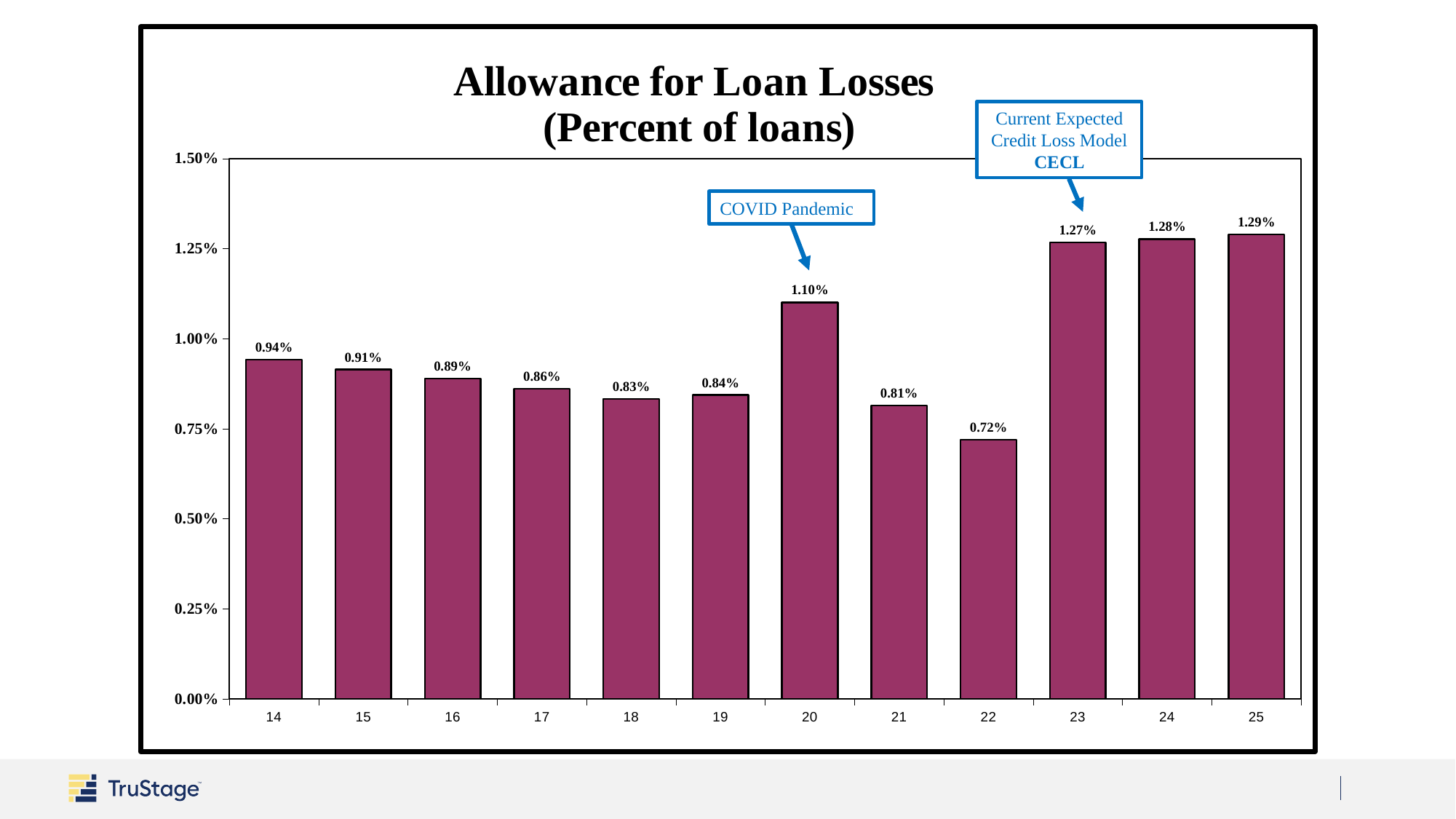
Is the value for 18 greater or less than 1.00%? less What is the value shown for 22? 0.72% Do the values rise or fall from 14 to 18? fall What is the allowance for loan losses value for 20? 1.10% Which is larger, the value for 15 or the value for 21? 15 Which year has the lowest allowance for loan losses? 22 Which year has the highest allowance for loan losses? 25 How many years are shown on the x axis? 12 Which year is labelled with the 'COVID Pandemic' callout? 20 What kind of chart is shown on the slide? bar chart What is the value shown for 14? 0.94% What is the difference between the values for 23 and 22? 0.55%